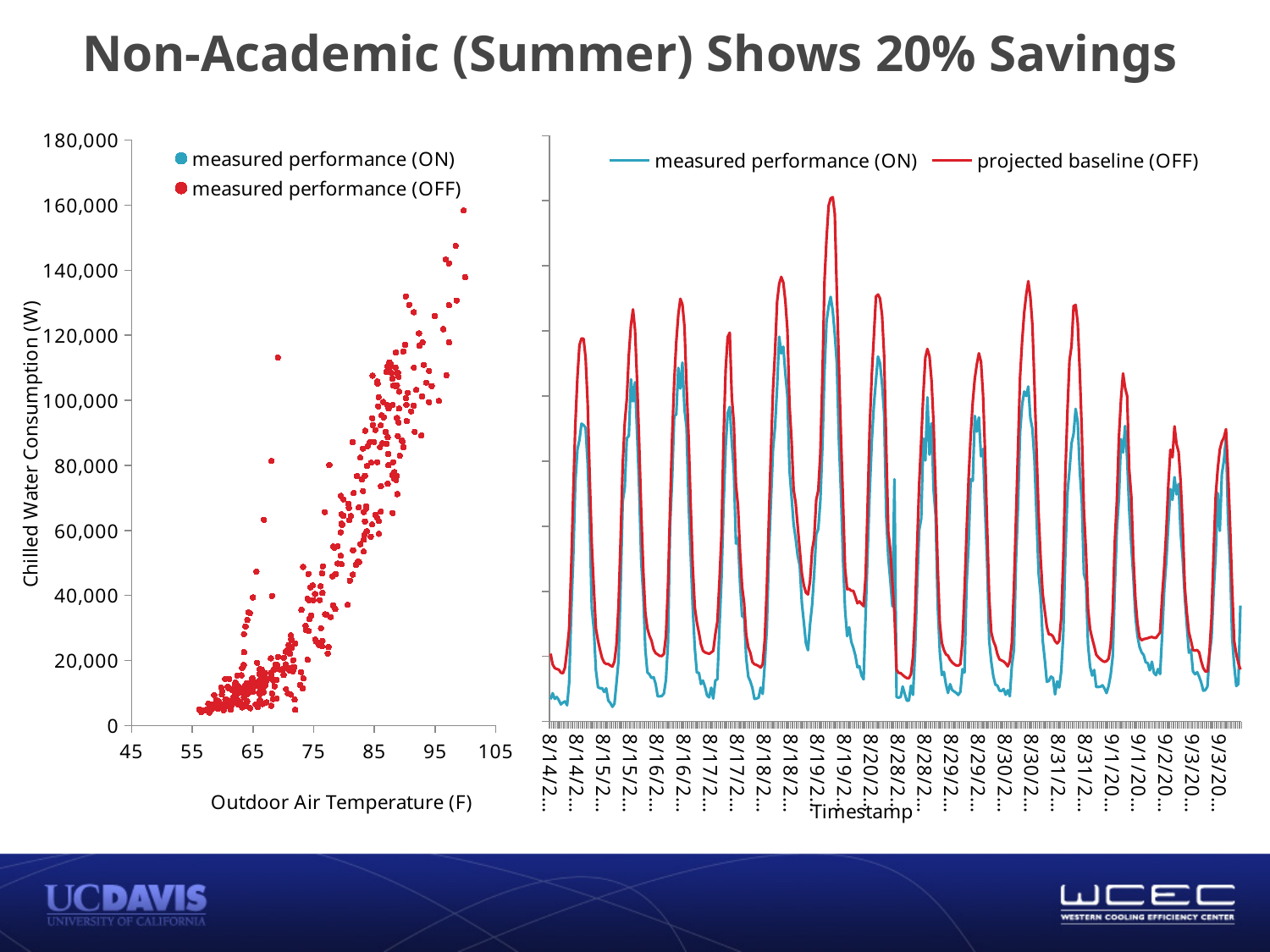
How many series does the legend of the right line chart list? 2 What kind of chart is the right chart (Timestamp on the x axis)? Line chart In the left scatter chart, is the highest measured performance (OFF) point greater or less than 140,000 W? Greater What kind of chart is the left chart (Chilled Water Consumption vs Outdoor Air Temperature)? Scatter chart What is the title of the slide? Non-Academic (Summer) Shows 20% Savings What colour is the projected baseline (OFF) line in the right line chart? Red What is the x-axis label of the left scatter chart? Outdoor Air Temperature (F) How many series does the legend of the left scatter chart list? 2 In the right line chart, which series generally has the higher peaks: measured performance (ON) or projected baseline (OFF)? Projected baseline (OFF) In the left scatter chart, are the lowest measured performance (OFF) points greater or less than 20,000 W? Less In the left scatter chart, does chilled water consumption generally rise or fall as outdoor air temperature increases? Rise